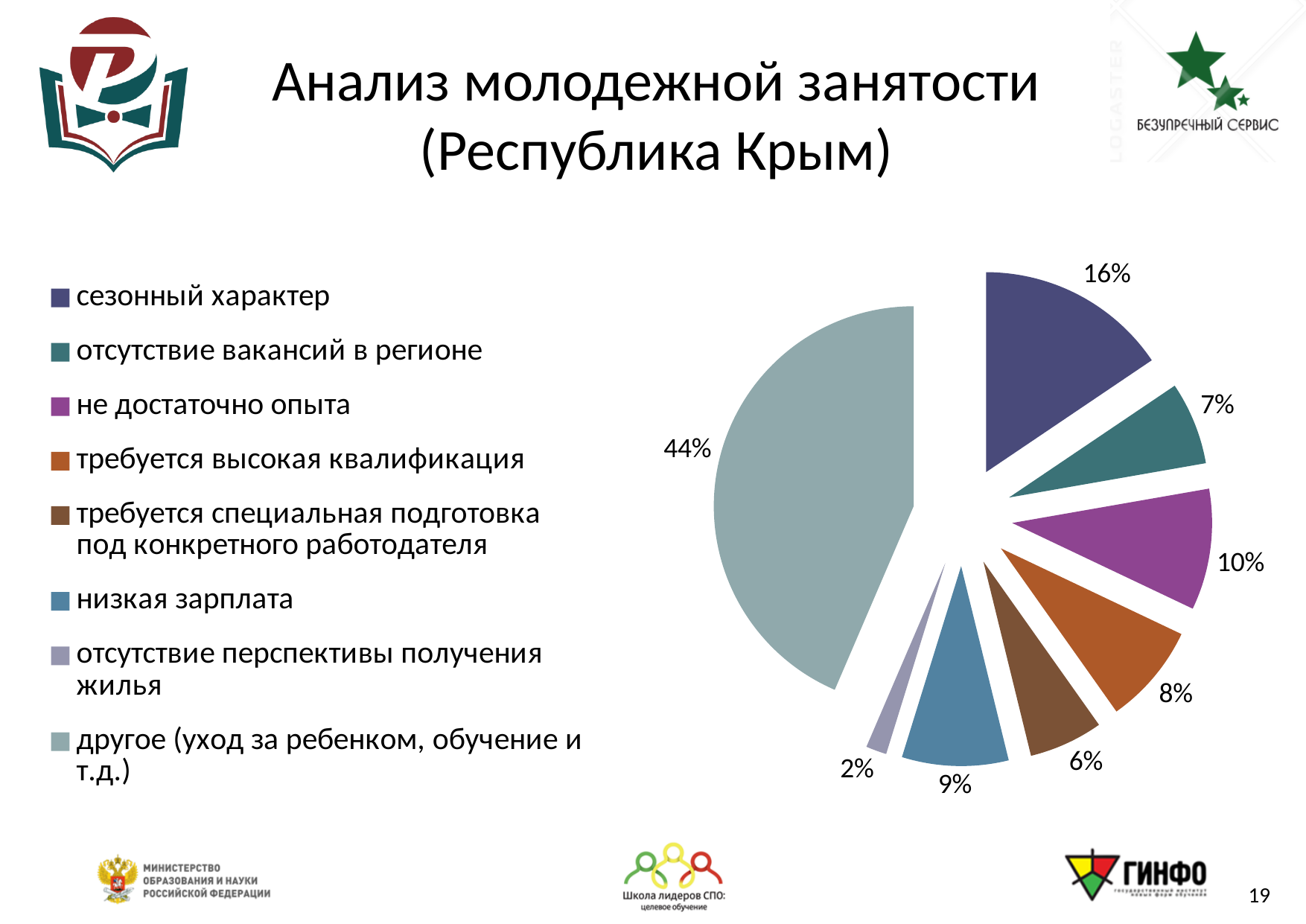
Which category has the smallest slice of the pie? отсутствие перспективы получения жилья Which is larger: the share for "требуется высокая квалификация" or the share for "низкая зарплата"? низкая зарплата What is the title of the slide containing the pie chart? Анализ молодежной занятости (Республика Крым) What kind of chart is shown on the slide? pie chart What share of the pie does "другое (уход за ребенком, обучение и т.д.)" have? 44% What share of the pie does "отсутствие перспективы получения жилья" have? 2% What is the difference in percentage points between "не достаточно опыта" and "отсутствие вакансий в регионе"? 3 What share of the pie does "сезонный характер" have? 16% How many categories does the pie chart have? 8 What share of the pie does "требуется специальная подготовка под конкретного работодателя" have? 6% What share of the pie does "низкая зарплата" have? 9% Which category has the largest slice of the pie? другое (уход за ребенком, обучение и т.д.)